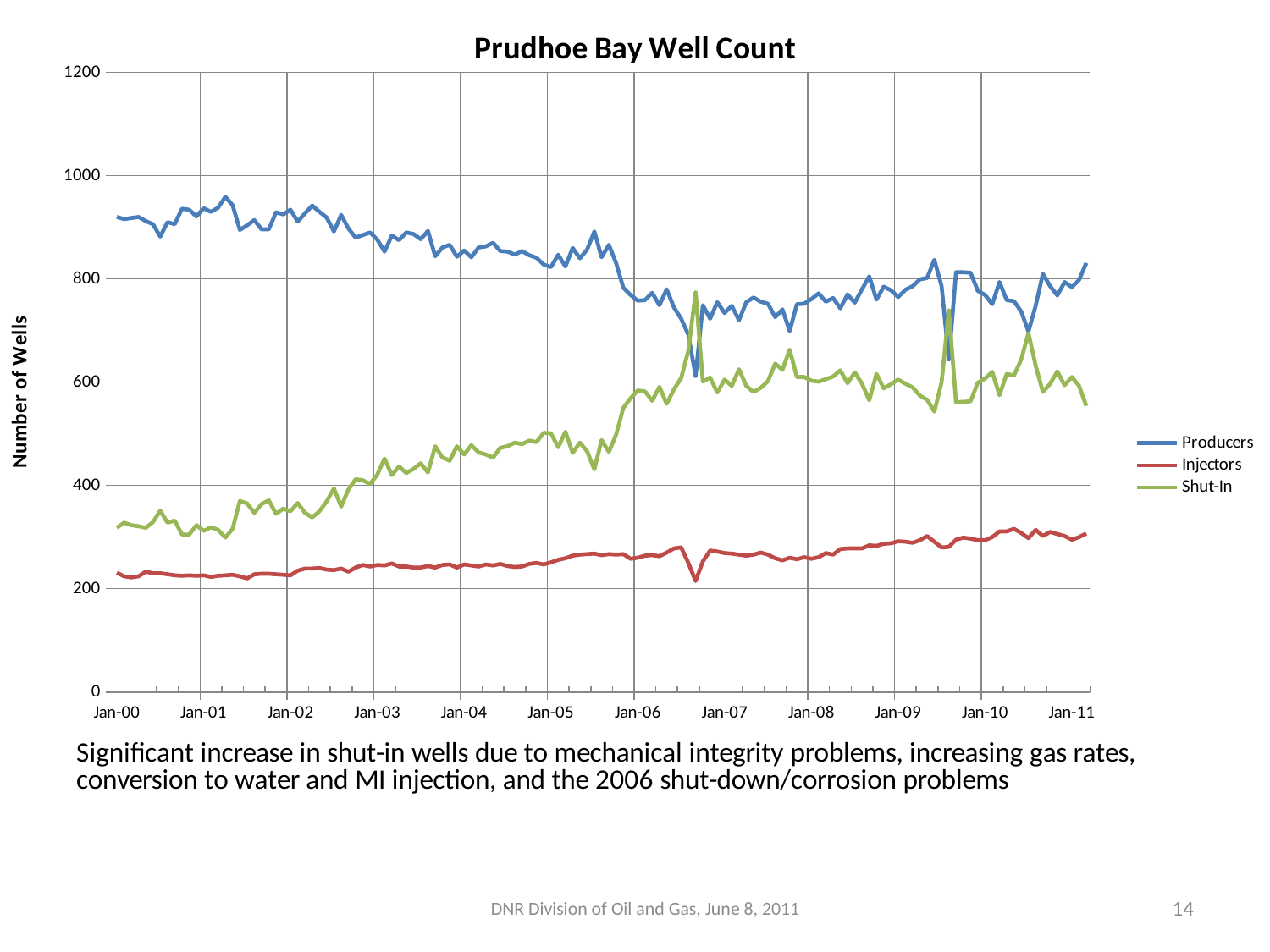
Is the Shut-In value at Jan-11 greater or less than 400? greater How many series does the legend list? 3 Is the Injectors value at Jan-00 greater or less than 400? less Is the Producers value at Jan-00 greater or less than 800? greater Does the Producers line generally rise or fall from Jan-00 to Jan-11? fall What is the title of the chart? Prudhoe Bay Well Count Which series has the lowest values across the whole period? Injectors What is the label on the vertical axis? Number of Wells At Jan-11, which is larger, Injectors or Shut-In? Shut-In At Jan-00, which is larger, Producers or Shut-In? Producers Does the Shut-In line generally rise or fall from Jan-00 to Jan-11? rise What kind of chart is shown on the slide? line chart